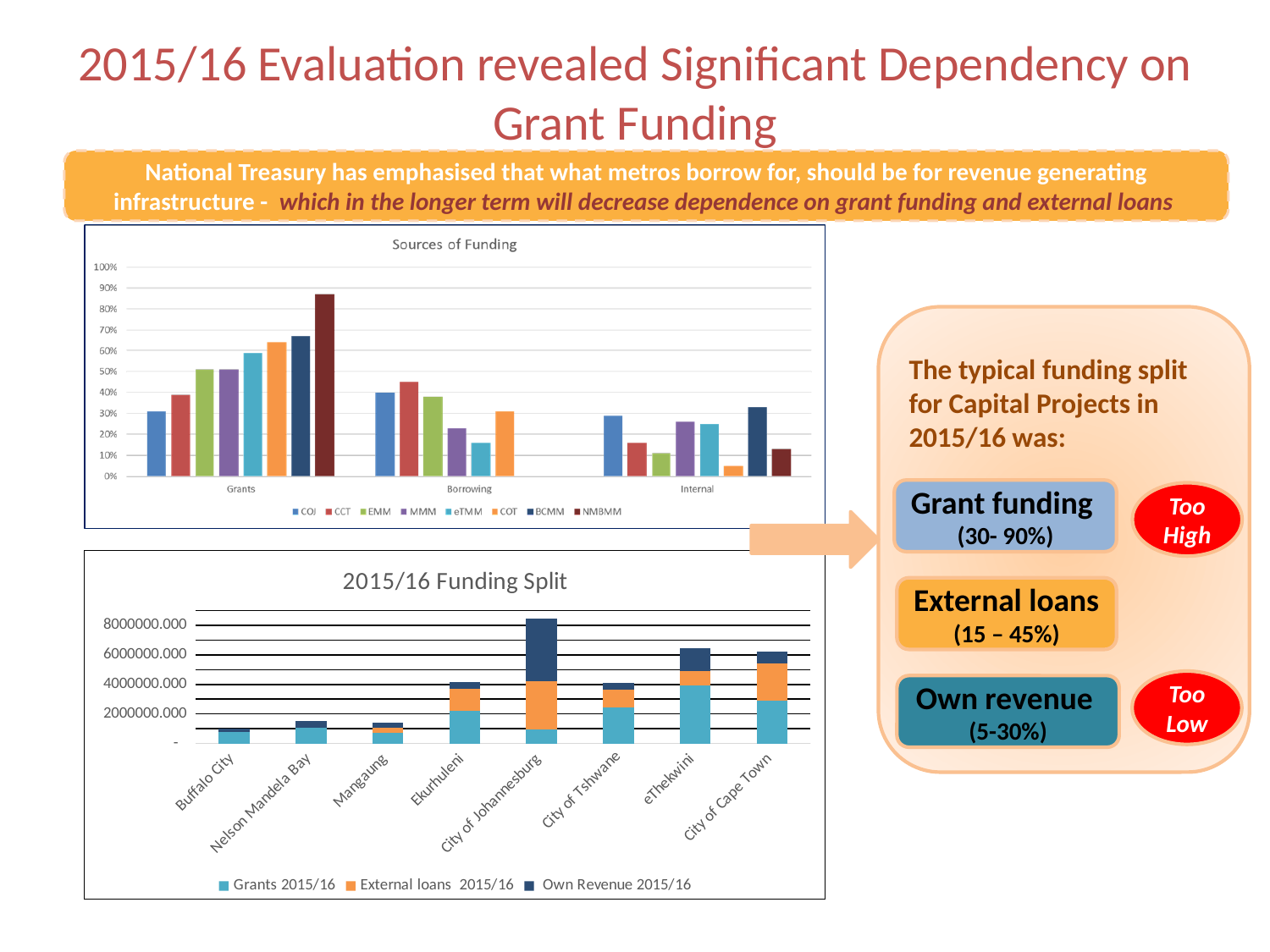
How many series does the legend of the '2015/16 Funding Split' chart list? 3 In the 'Sources of Funding' chart, which has the larger Grants value, COJ or CCT? CCT In the 'Sources of Funding' chart, which metro has the lowest value for Internal? COT In the 'Sources of Funding' chart, which metro has the highest value for Grants? NMBMM What type of chart is the 'Sources of Funding' chart? Bar chart In the 'Sources of Funding' chart, is the Grants value for NMBMM greater or less than 80%? greater What type of chart is the '2015/16 Funding Split' chart? Stacked bar chart In the '2015/16 Funding Split' chart, is the total stacked bar for City of Johannesburg greater or less than 6000000.000? greater How many series does the legend of the 'Sources of Funding' chart list? 8 In the '2015/16 Funding Split' chart, which metro has the tallest stacked bar? City of Johannesburg How many categories are shown on the x axis of the 'Sources of Funding' chart? 3 How many metros are shown on the x axis of the '2015/16 Funding Split' chart? 8